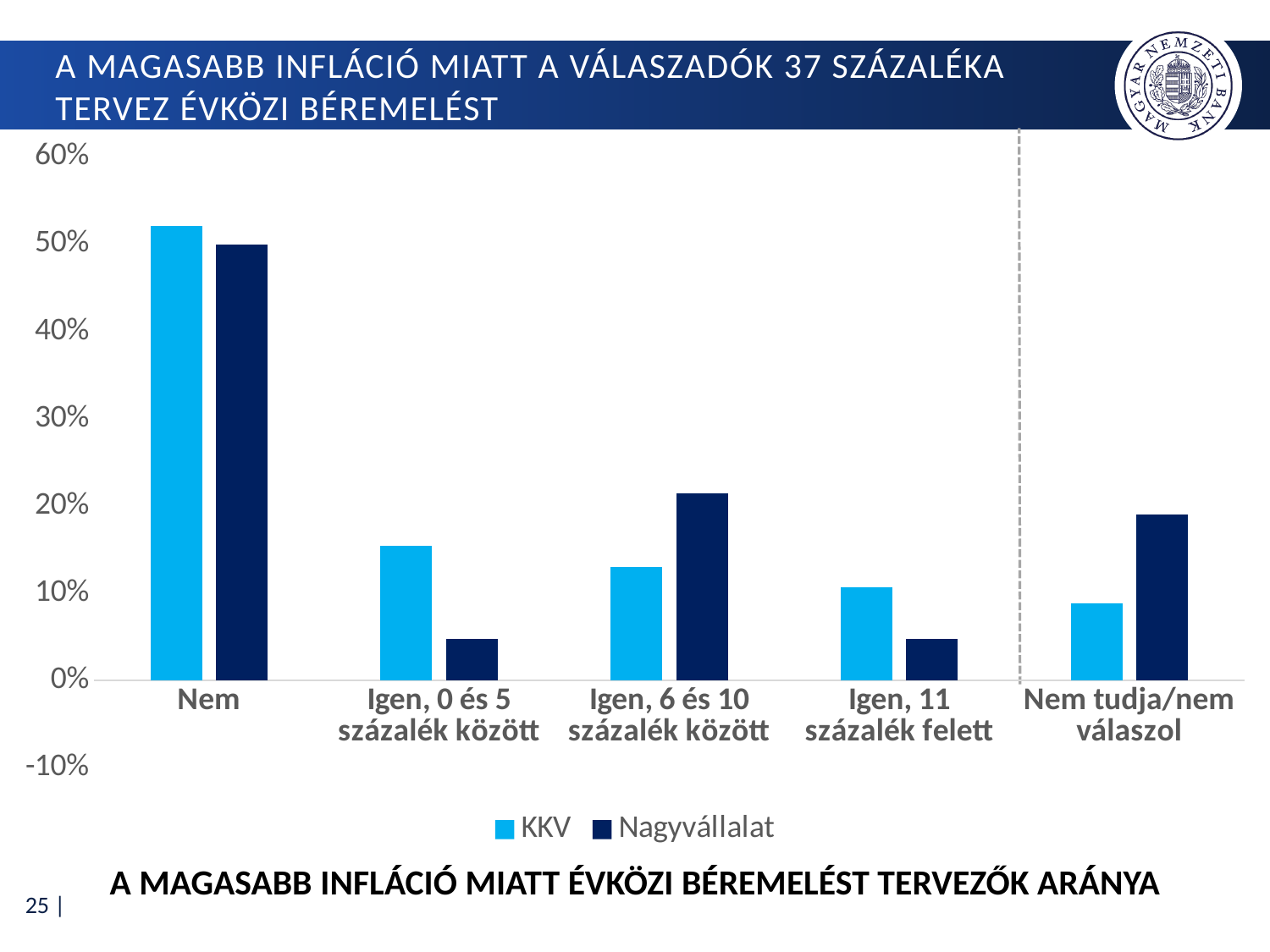
In the category 'Igen, 0 és 5 százalék között', which series has the larger value, KKV or Nagyvállalat? KKV Is the KKV value for 'Nem' greater or less than 50%? greater How many series does the legend list? 2 Which category has the highest value for the Nagyvállalat series? Nem Is the Nagyvállalat value for 'Nem tudja/nem válaszol' greater or less than 10%? greater How many categories are shown on the x axis of the chart? 5 Which category has the lowest value for the KKV series? Nem tudja/nem válaszol Which category has the highest value for the KKV series? Nem Is the Nagyvállalat value for 'Igen, 11 százalék felett' greater or less than 10%? less In the category 'Igen, 6 és 10 százalék között', which series has the larger value, KKV or Nagyvállalat? Nagyvállalat What are the two series named in the legend? KKV and Nagyvállalat What kind of chart is shown on the slide? bar chart